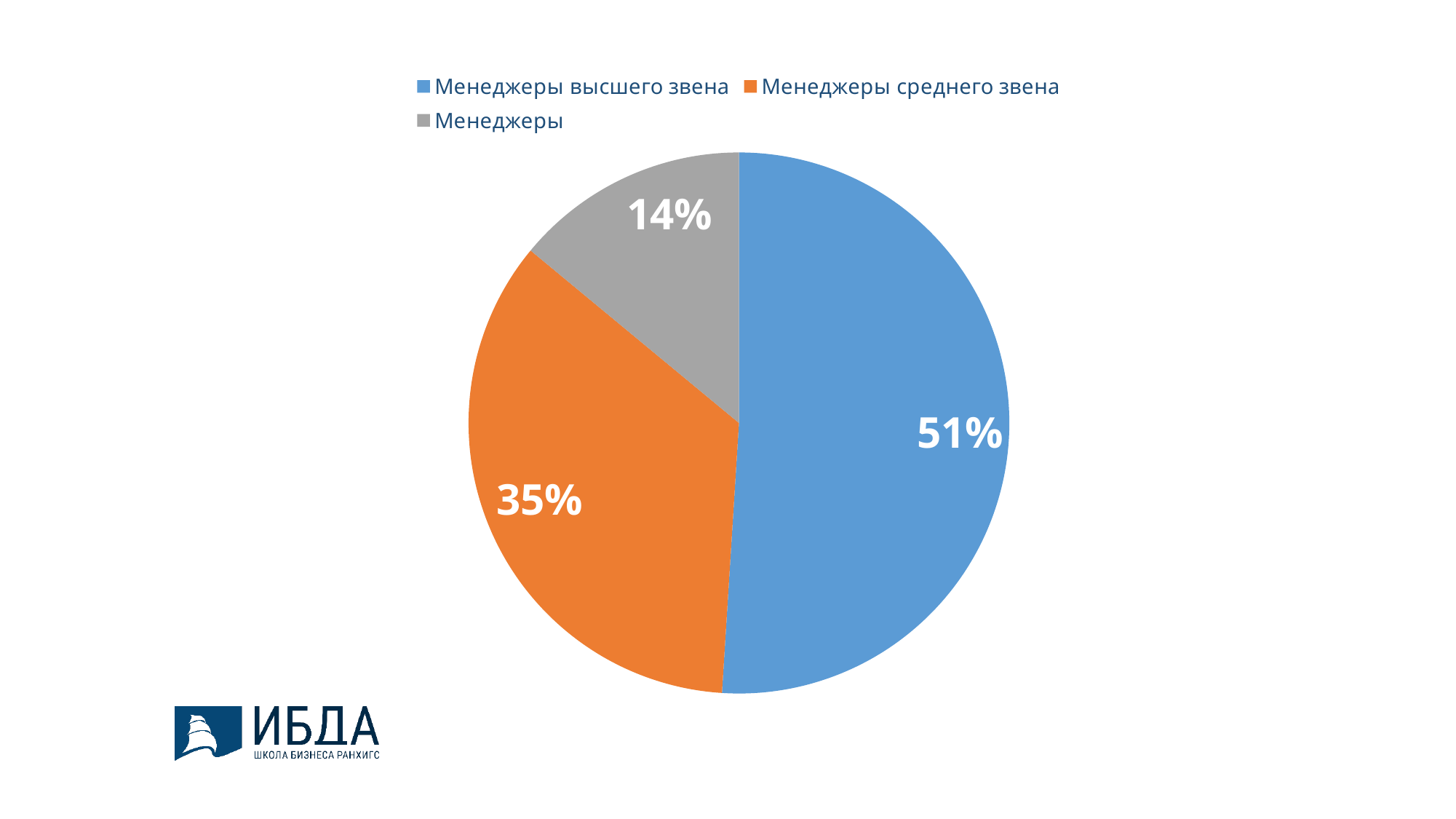
What share of the pie is labelled for Менеджеры высшего звена? 51% How many slices does the pie chart have? 3 What share of the pie is labelled for Менеджеры? 14% Which category has the smallest slice of the pie? Менеджеры How many entries does the legend list? 3 Which slice is larger: Менеджеры среднего звена or Менеджеры? Менеджеры среднего звена What share of the pie is labelled for Менеджеры среднего звена? 35% What is the difference in percentage points between the Менеджеры высшего звена slice and the Менеджеры среднего звена slice? 16 What colour is the slice for Менеджеры среднего звена? orange What kind of chart is shown on the slide? pie chart What colour is the slice for Менеджеры? grey Which category has the largest slice of the pie? Менеджеры высшего звена